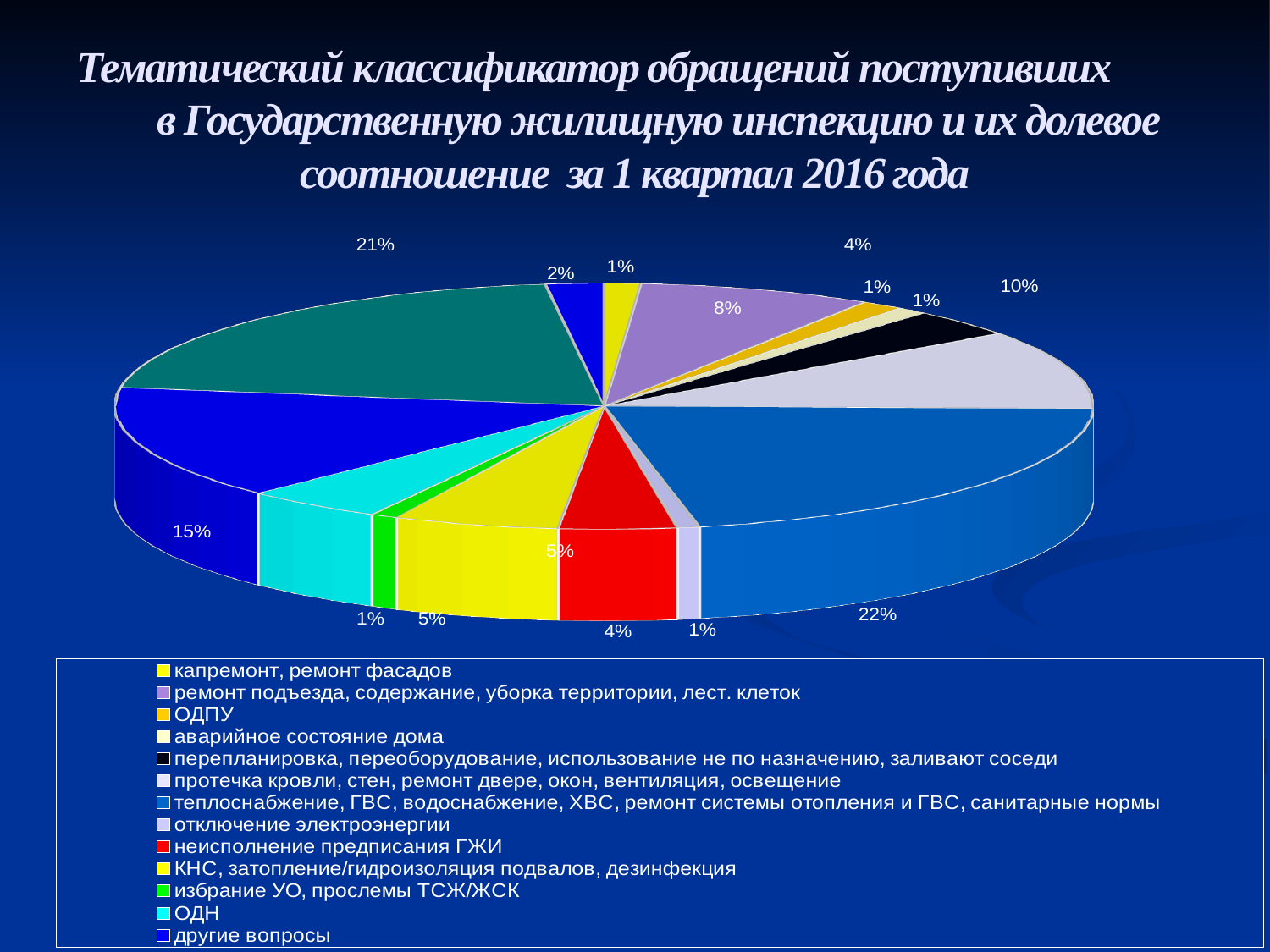
What share of the pie does 'неисполнение предписания ГЖИ' (red slice) have? 4% Which slice is larger: 'другие вопросы' or 'ремонт подъезда, содержание, уборка территории, лест. клеток'? другие вопросы What share of the pie does 'протечка кровли, стен, ремонт двере, окон, вентиляция, освещение' have? 10% What share of the pie does 'другие вопросы' (dark blue slice) have? 15% How many entries does the legend list? 13 What is the difference between the share of 'протечка кровли, стен, ремонт двере, окон, вентиляция, освещение' and the share of 'ОДН'? 5% What kind of chart is shown on the slide? pie chart What is the largest percentage label shown on the pie chart? 22%